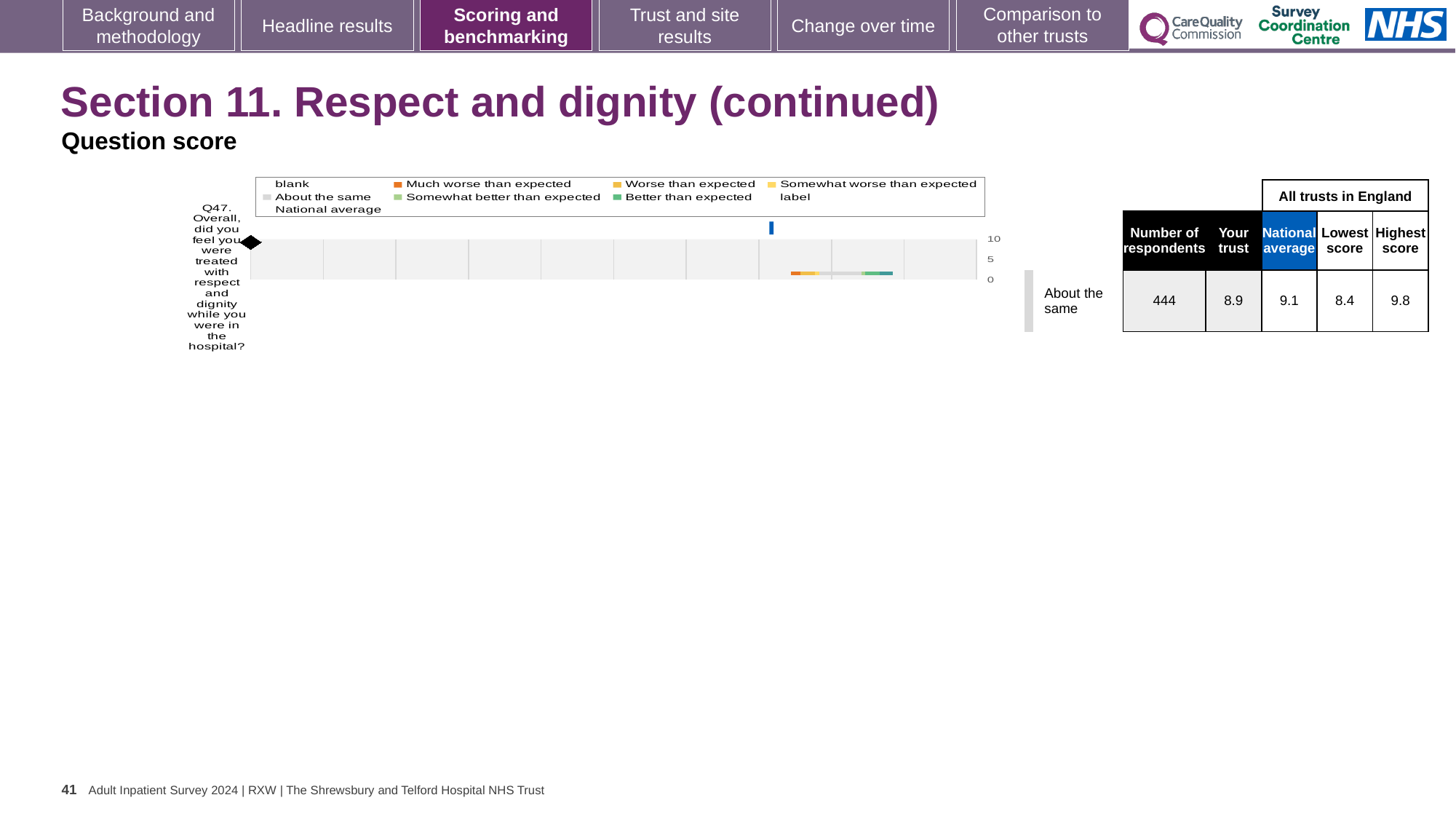
What is the highest value shown on the chart's score axis? 10 What is the national average score for Q47? 9.1 Is the trust's score for Q47 greater or less than 5? greater How many survey questions are plotted on the chart? 1 Which benchmarking category is the trust's score for Q47 placed in? About the same How many respondents answered Q47? 444 What is the difference between the highest and lowest scores for Q47 across all trusts in England? 1.4 What is the lowest score among all trusts in England for Q47? 8.4 What is the 'Your trust' score for Q47? 8.9 What kind of chart is shown on the slide? bar chart Which is larger for Q47, the trust's score or the national average? National average What is the highest score among all trusts in England for Q47? 9.8